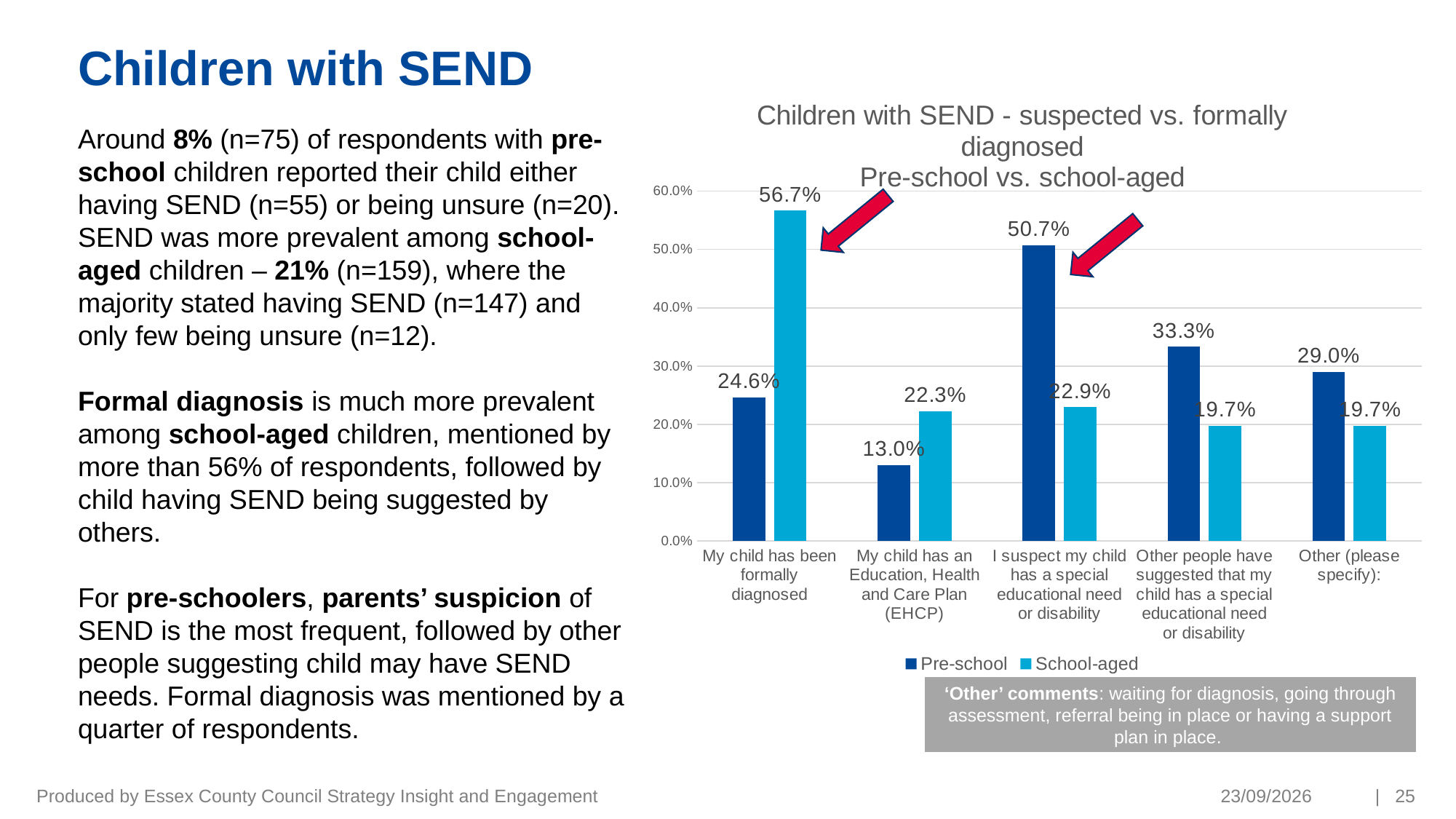
What is the School-aged value for 'My child has been formally diagnosed'? 56.7% What is the difference between the School-aged and Pre-school values for 'My child has been formally diagnosed'? 32.1% How many categories are shown on the x axis of the chart? 5 What kind of chart is shown on the slide? Bar chart What is the title of the chart? Children with SEND - suspected vs. formally diagnosed Pre-school vs. school-aged What is the Pre-school value for 'I suspect my child has a special educational need or disability'? 50.7% For 'Other people have suggested that my child has a special educational need or disability', which series has the larger value, Pre-school or School-aged? Pre-school What is the Pre-school value for 'My child has an Education, Health and Care Plan (EHCP)'? 13.0% Which category has the highest Pre-school value? I suspect my child has a special educational need or disability Is the Pre-school value for 'Other (please specify)' greater or less than 20.0%? greater How many series does the chart legend list? 2 Which category has the lowest School-aged value? Other people have suggested that my child has a special educational need or disability and Other (please specify), both 19.7%